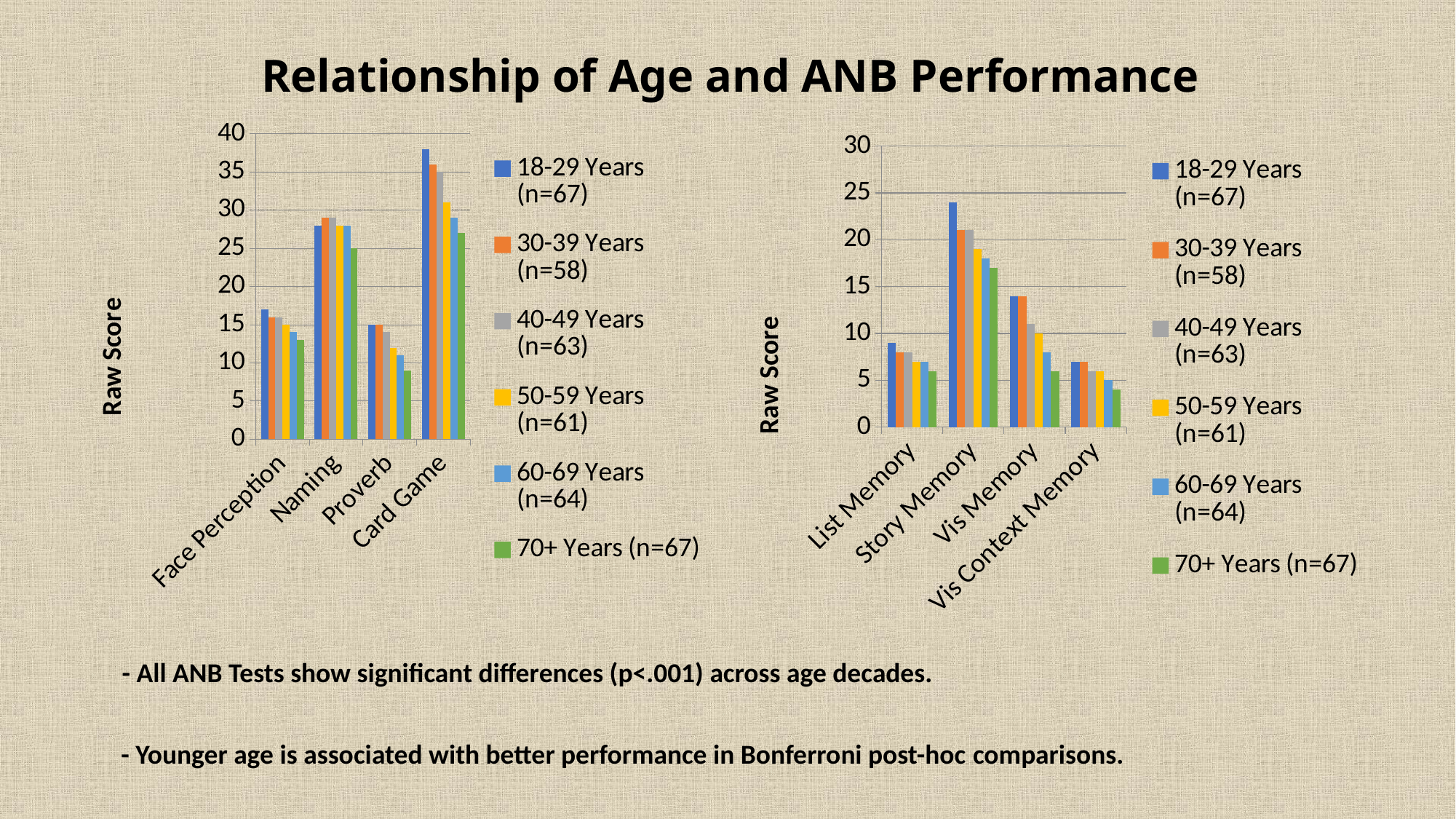
What is the label on the y axis of the right chart? Raw Score How many categories are shown on the x axis of the left chart? 4 In the left chart, which is larger for Card Game: the value for 18-29 Years (n=67) or the value for 70+ Years (n=67)? 18-29 Years (n=67) In the right chart, is the value for Story Memory for 18-29 Years (n=67) greater or less than 20? greater What kind of chart is the left chart on the slide? bar chart In the right chart, is the value for Vis Context Memory for 70+ Years (n=67) greater or less than 5? less In the right chart, which category has the lowest bar for 70+ Years (n=67)? Vis Context Memory In the left chart, is the value for Proverb for 70+ Years (n=67) greater or less than 10? less How many series does the legend of the right chart list? 6 In the right chart, which category has the highest bar for 18-29 Years (n=67)? Story Memory In the left chart, which category has the highest bar for 18-29 Years (n=67)? Card Game